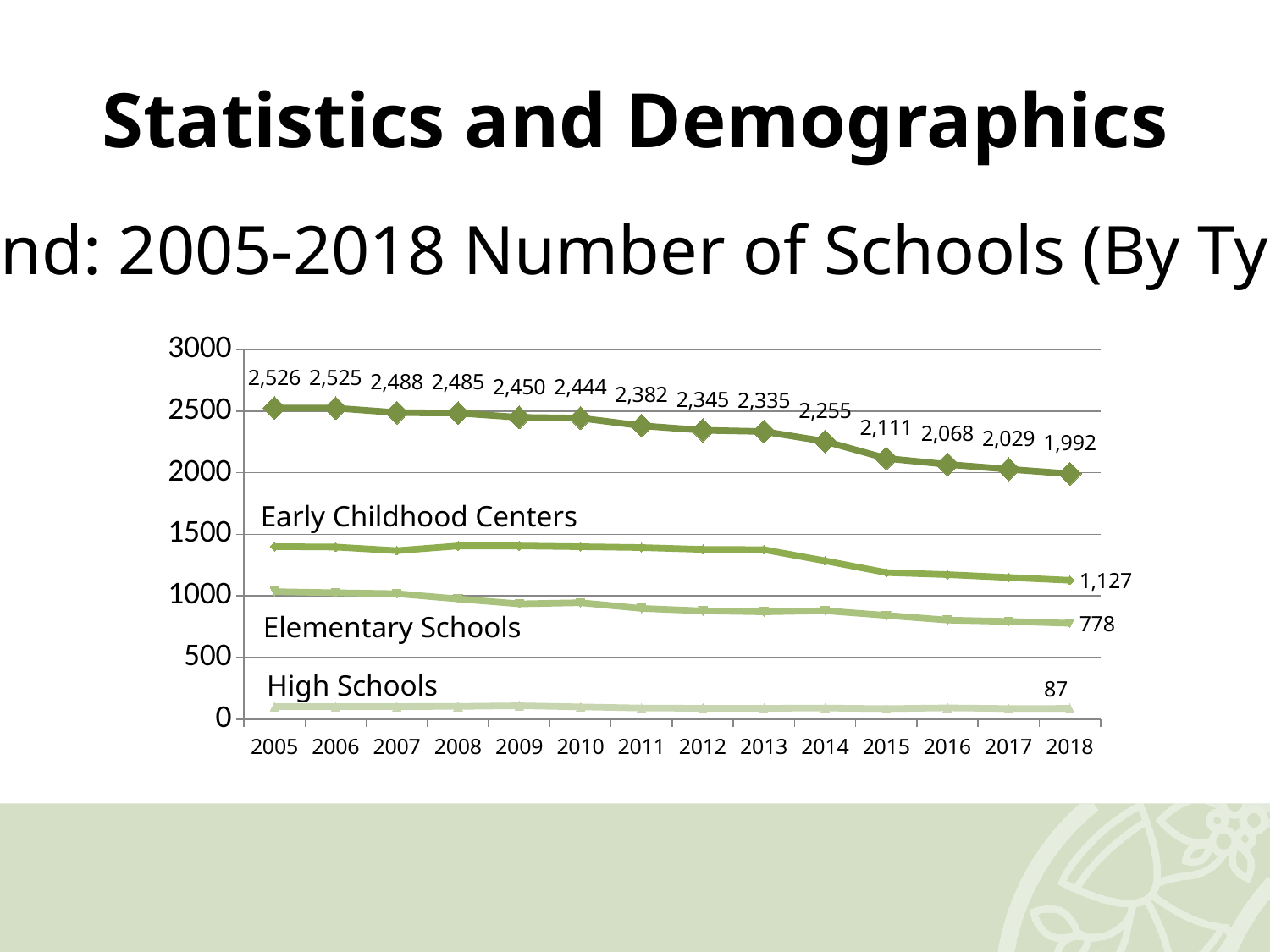
What is the value of the top line (with diamond markers) in 2005? 2,526 What is the value for High Schools in 2018? 87 What kind of chart is shown on the slide? line chart By how much did the top line (with diamond markers) decrease from 2005 to 2018? 534 What is the value for Elementary Schools in 2018? 778 In which year is the top line (with diamond markers) at its lowest value? 2018 Is the value for Early Childhood Centers in 2005 greater or less than 1500? less What is the difference in the top line (with diamond markers) between 2014 and 2015? 144 What is the value of the top line (with diamond markers) in 2018? 1,992 How many years are shown on the x axis? 14 Does the top line (with diamond markers) rise or fall from 2005 to 2018? fall What is the value for Early Childhood Centers in 2018? 1,127